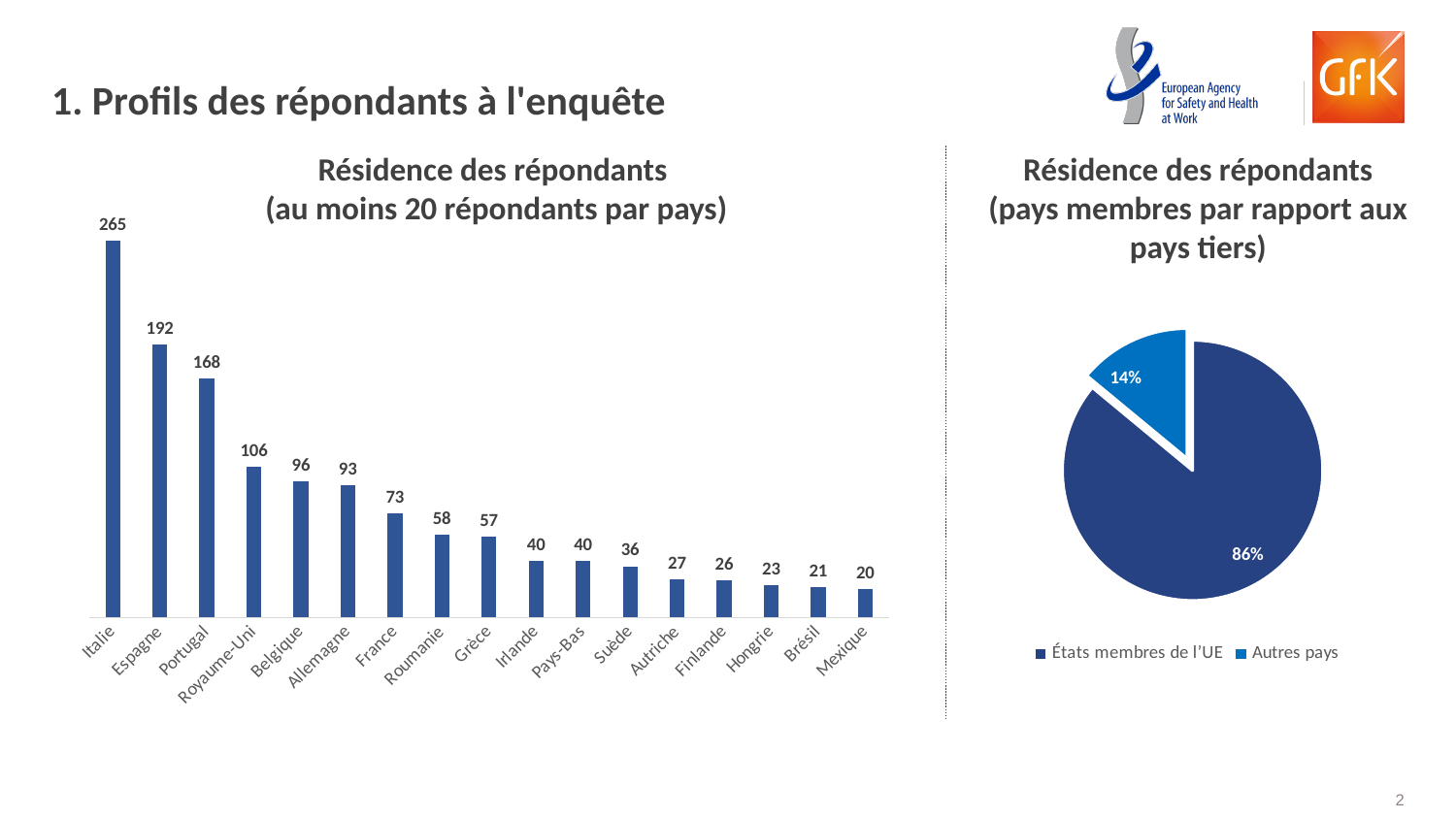
How many countries are shown in the bar chart 'Résidence des répondants (au moins 20 répondants par pays)'? 17 In the pie chart 'Résidence des répondants (pays membres par rapport aux pays tiers)', what share is 'États membres de l'UE'? 86% What type of chart is 'Résidence des répondants (au moins 20 répondants par pays)'? Bar chart In the bar chart 'Résidence des répondants (au moins 20 répondants par pays)', do the values rise or fall from left to right? Fall In the bar chart 'Résidence des répondants (au moins 20 répondants par pays)', what is the difference between the values for Espagne and Portugal? 24 In the bar chart 'Résidence des répondants (au moins 20 répondants par pays)', which country has the highest value? Italie How many entries does the legend of the pie chart 'Résidence des répondants (pays membres par rapport aux pays tiers)' list? 2 In the bar chart 'Résidence des répondants (au moins 20 répondants par pays)', what is the value for Italie? 265 In the pie chart 'Résidence des répondants (pays membres par rapport aux pays tiers)', what share is 'Autres pays'? 14% In the bar chart 'Résidence des répondants (au moins 20 répondants par pays)', which has a larger value, Belgique or Allemagne? Belgique In the bar chart 'Résidence des répondants (au moins 20 répondants par pays)', which country has the lowest value? Mexique In the bar chart 'Résidence des répondants (au moins 20 répondants par pays)', what is the value for France? 73